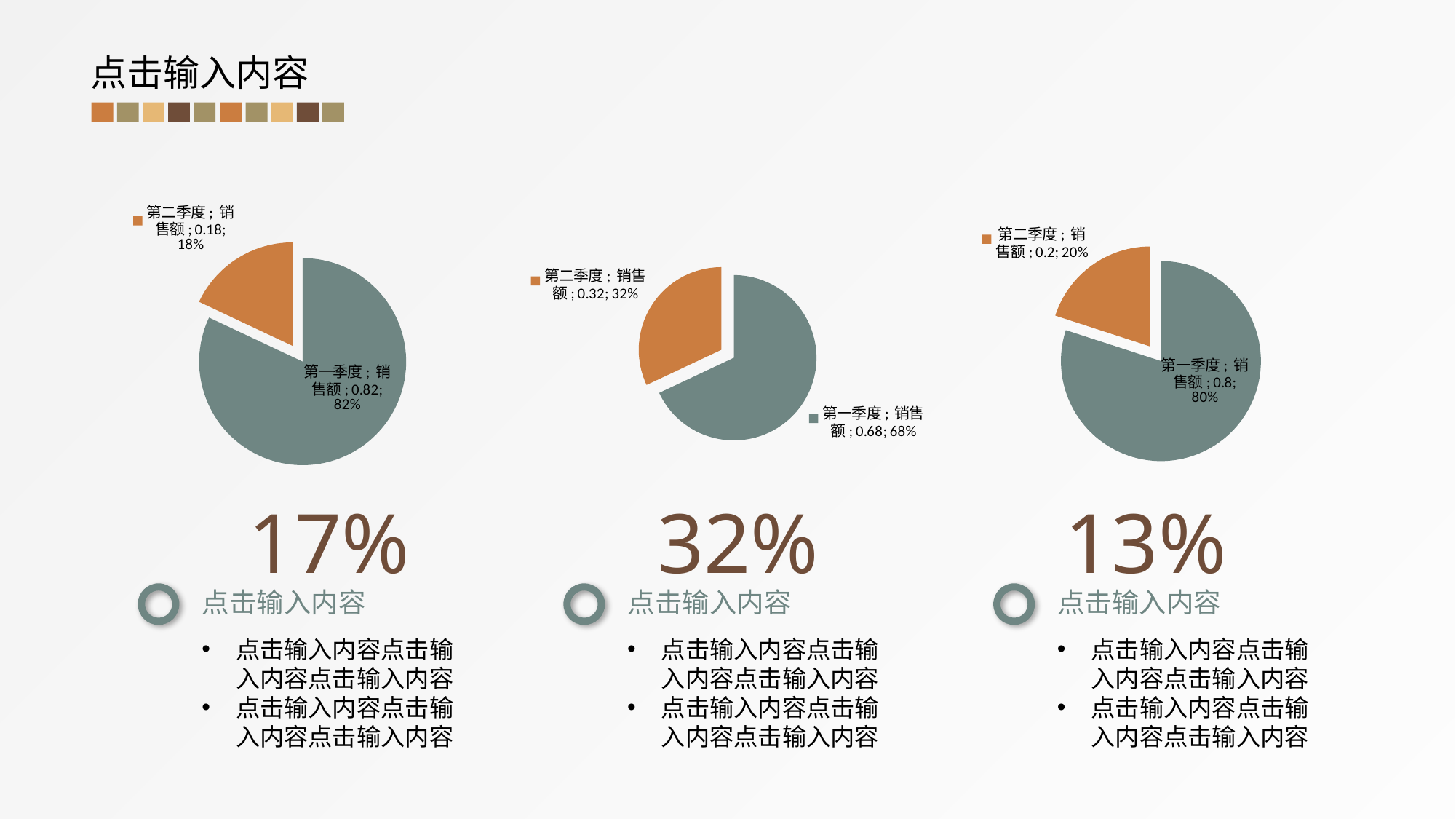
In the middle pie chart, what share of the pie does 第一季度 take? 68% In the right pie chart, what is the difference between the values for 第一季度 and 第二季度? 0.6 In the left pie chart, what share of the pie does 第二季度 take? 18% In the middle pie chart, which is larger, 第一季度 or 第二季度? 第一季度 In the right pie chart, what is the value shown for 第一季度? 0.8 In the left pie chart, what is the value shown for 第一季度? 0.82 In the left pie chart, which slice is the largest? 第一季度 In the middle pie chart, which slice is the smallest? 第二季度 In the right pie chart, what share of the pie does 第二季度 take? 20% How many slices does the left pie chart have? 2 In the middle pie chart, what is the value shown for 第二季度? 0.32 What type of chart is the middle chart on the slide? Pie chart